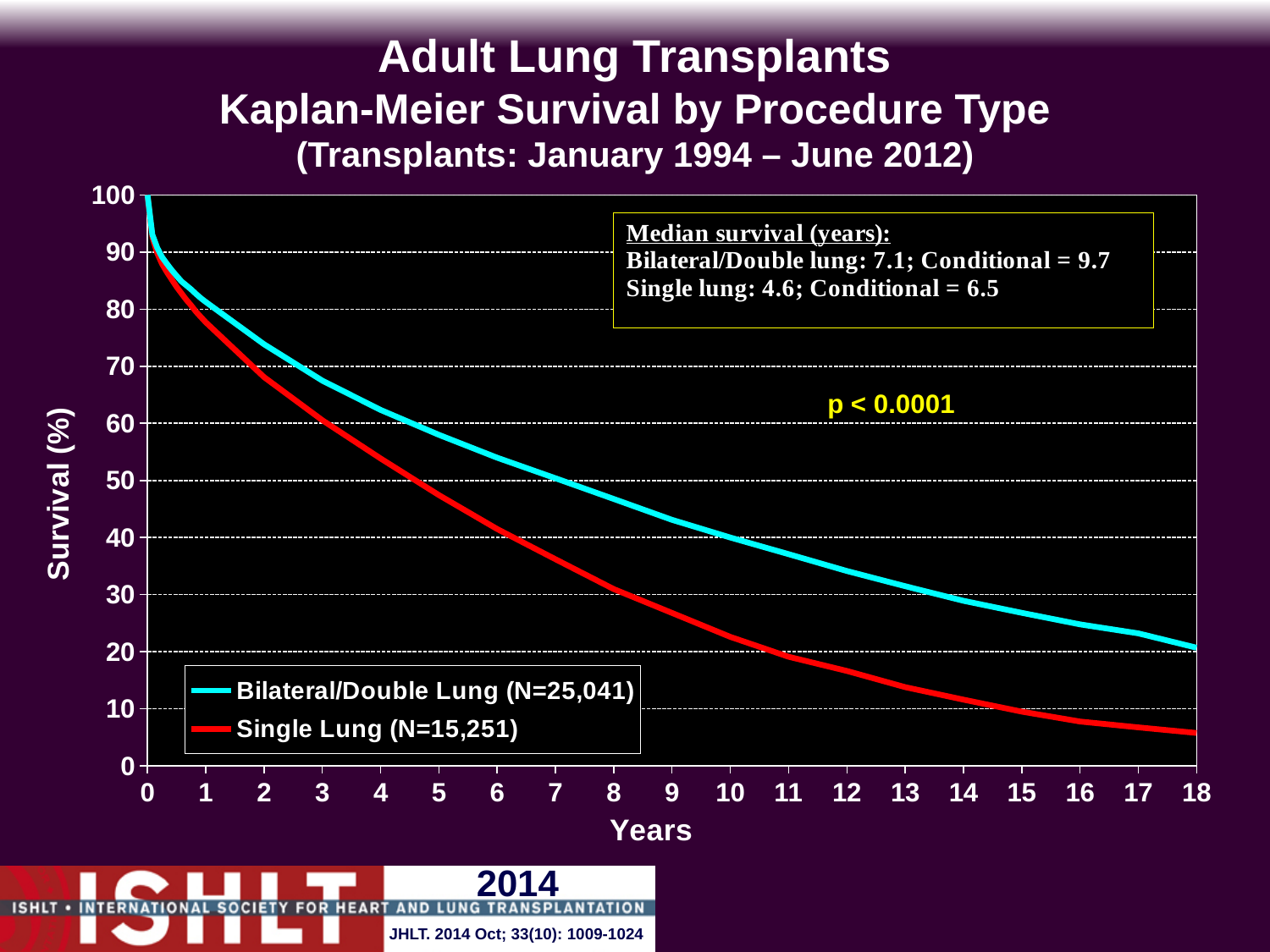
What is the N for the Single Lung group shown in the legend? 15,251 What is the N for the Bilateral/Double Lung group shown in the legend? 25,041 What kind of chart is shown on the slide? line chart Do the survival curves rise or fall as years increase? fall What is the median survival in years for Bilateral/Double lung transplants, as stated in the text box? 7.1 What is the conditional median survival in years for Bilateral/Double lung transplants? 9.7 How many series does the legend list? 2 Which procedure type has the higher survival at 5 years, Bilateral/Double Lung or Single Lung? Bilateral/Double Lung What is the median survival in years for Single lung transplants, as stated in the text box? 4.6 Is the survival value for Bilateral/Double Lung at 5 years greater or less than 50? greater What is the conditional median survival in years for Single lung transplants? 6.5